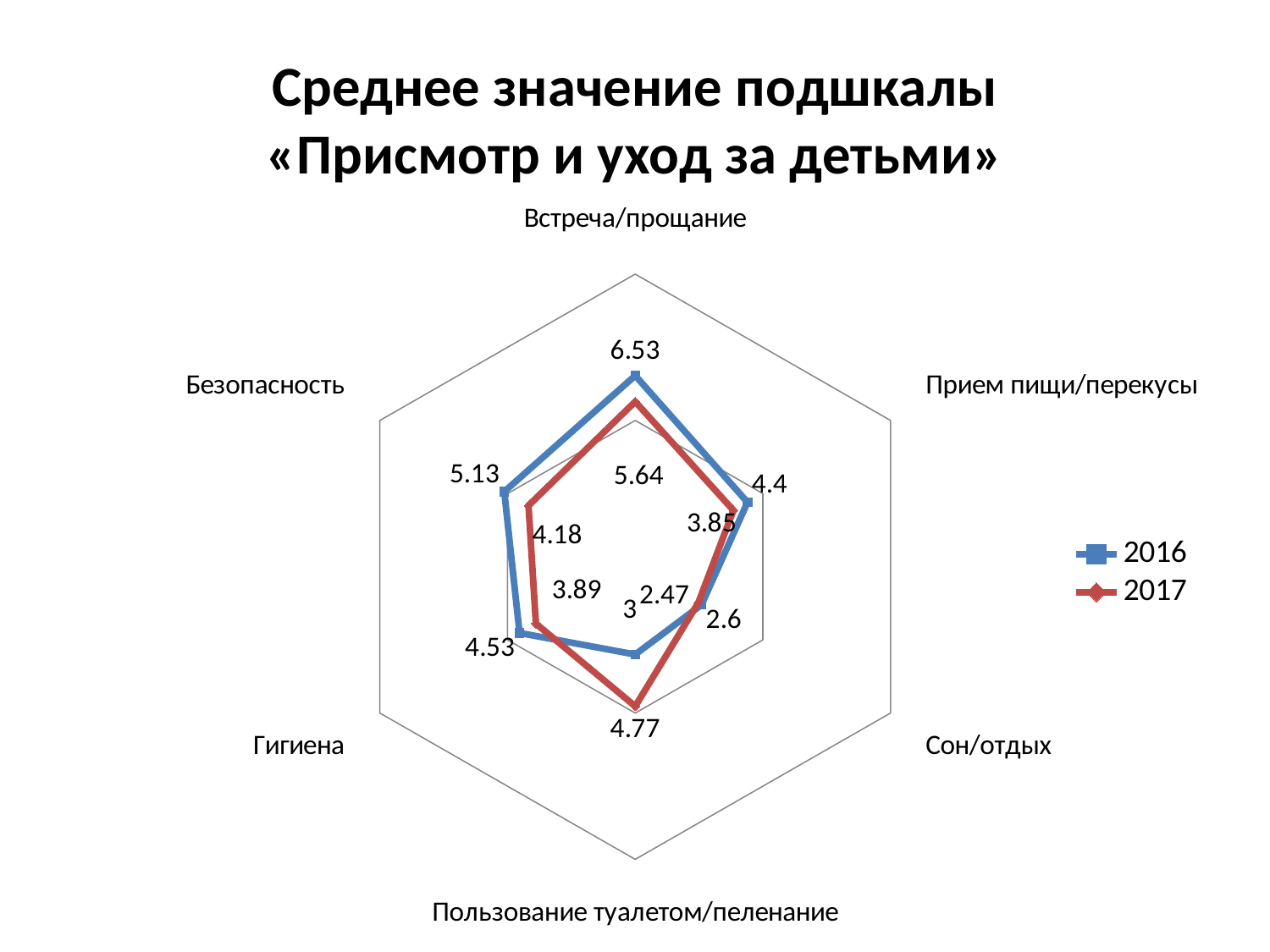
What is the 2016 value for Встреча/прощание? 6.53 What is the difference between the 2016 and 2017 values for Встреча/прощание? 0.89 What kind of chart is shown on the slide? Radar chart What is the 2016 value for Сон/отдых? 2.6 Which series is drawn in red? 2017 What is the 2017 value for Пользование туалетом/пеленание? 4.77 How many categories (axes) does the radar chart have? 6 What is the 2017 value for Безопасность? 4.18 Which category has the highest 2016 value? Встреча/прощание For Пользование туалетом/пеленание, which year has the larger value, 2016 or 2017? 2017 How many series does the legend list? 2 Which category has the lowest 2017 value? Сон/отдых